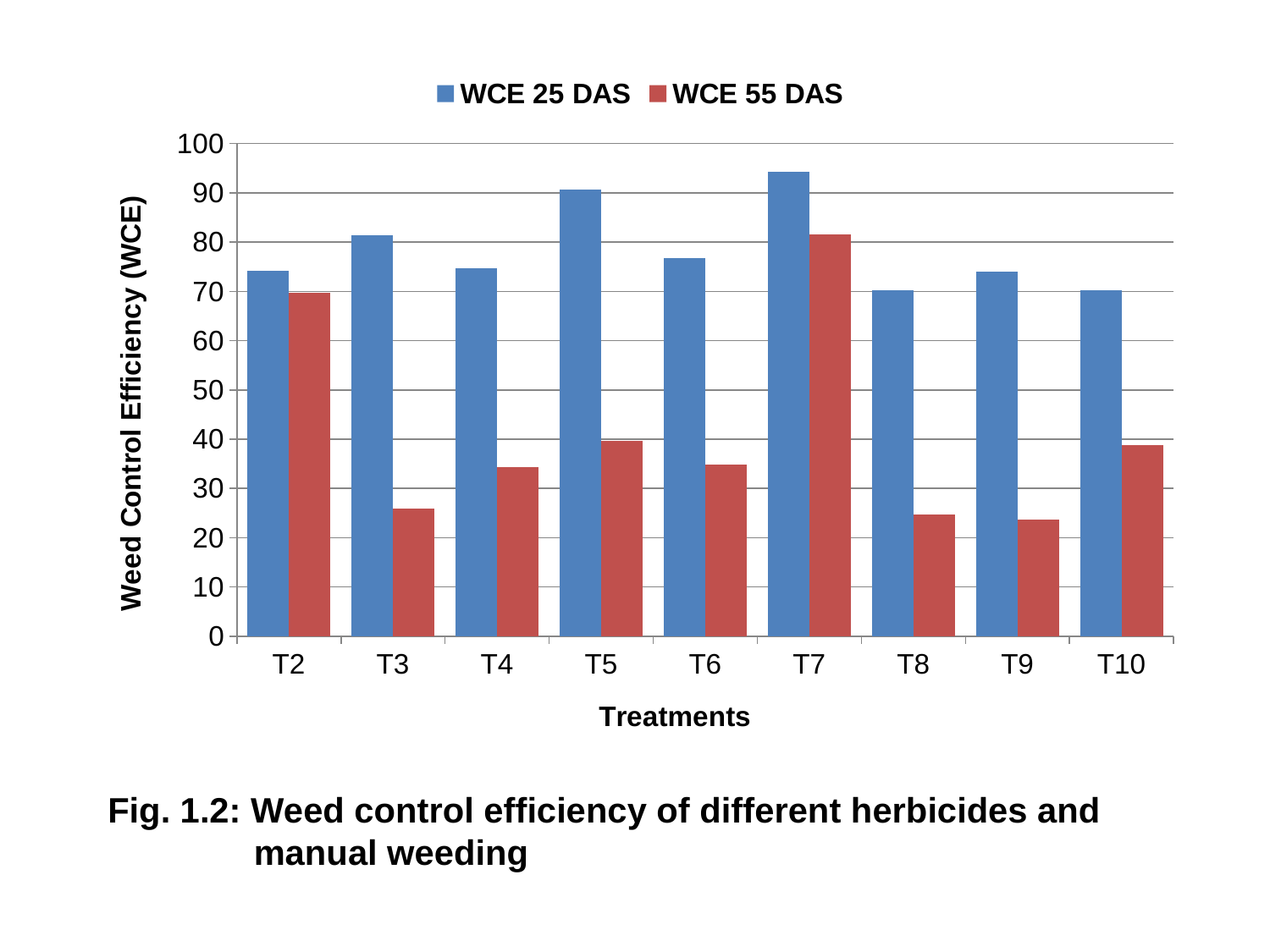
What is the title of the y axis? Weed Control Efficiency (WCE) Is the WCE 25 DAS value for T8 greater or less than 60? greater Which treatment has the highest WCE 55 DAS value? T7 How many series does the legend list? 2 Which treatment has the highest WCE 25 DAS value? T7 Is the WCE 55 DAS value for T3 greater or less than 30? less What kind of chart is shown on the slide? bar chart Which is larger, the WCE 55 DAS value for T2 or for T4? T2 Is the WCE 55 DAS value for T7 greater or less than 70? greater How many treatments are shown on the x axis? 9 Which is larger, the WCE 25 DAS value for T3 or for T4? T3